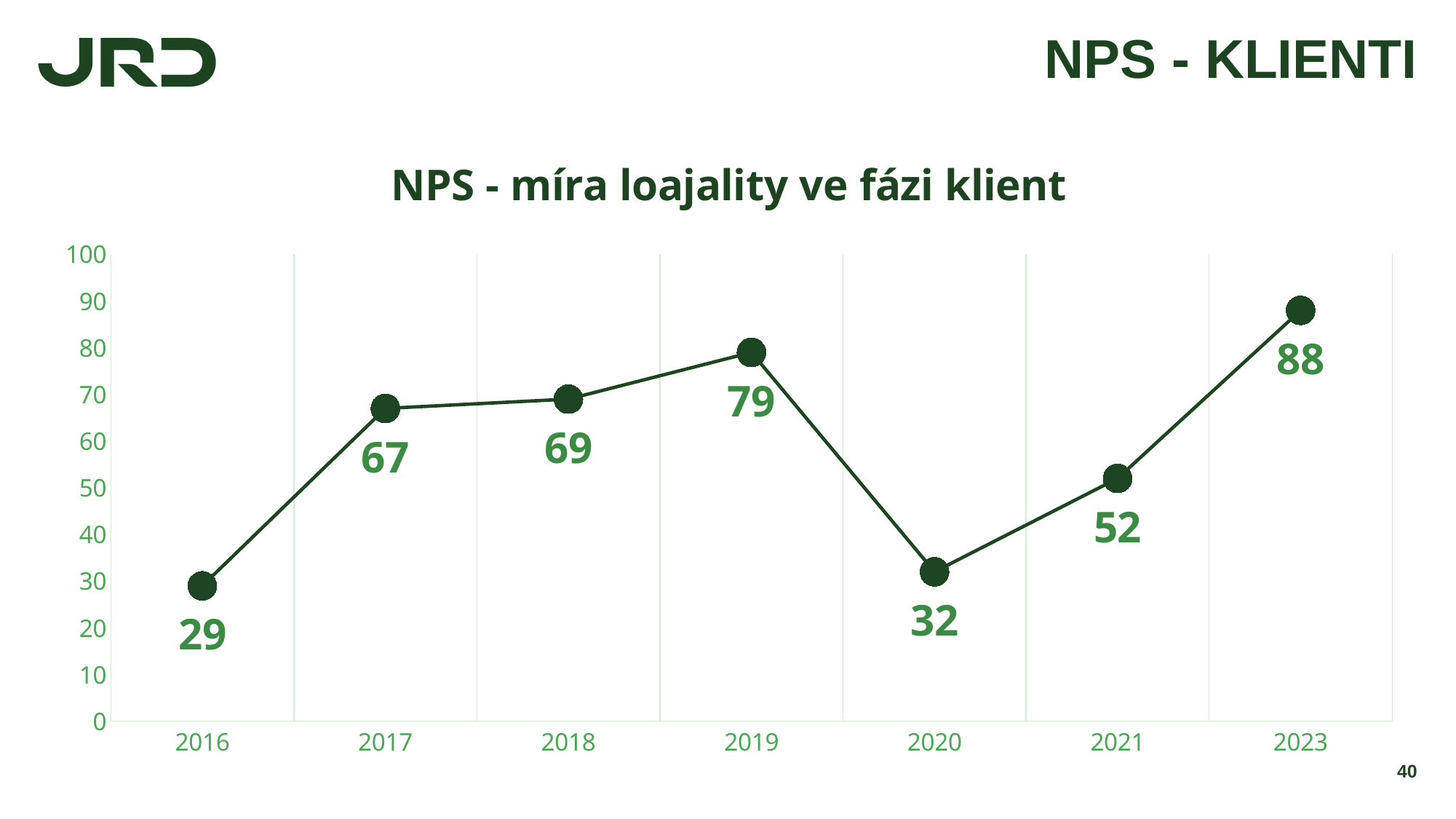
How many years are plotted on the chart? 7 Which year has the lowest NPS value? 2016 What kind of chart is shown on the slide? line chart What is the NPS value for 2019? 79 What is the difference between the NPS values for 2023 and 2020? 56 What is the NPS value for 2016? 29 Is the NPS value for 2020 greater or less than 40? less Which year has the highest NPS value? 2023 What is the title of the chart? NPS - míra loajality ve fázi klient What is the NPS value for 2021? 52 What is the difference between the NPS values for 2019 and 2018? 10 Which year has a higher NPS value, 2017 or 2021? 2017